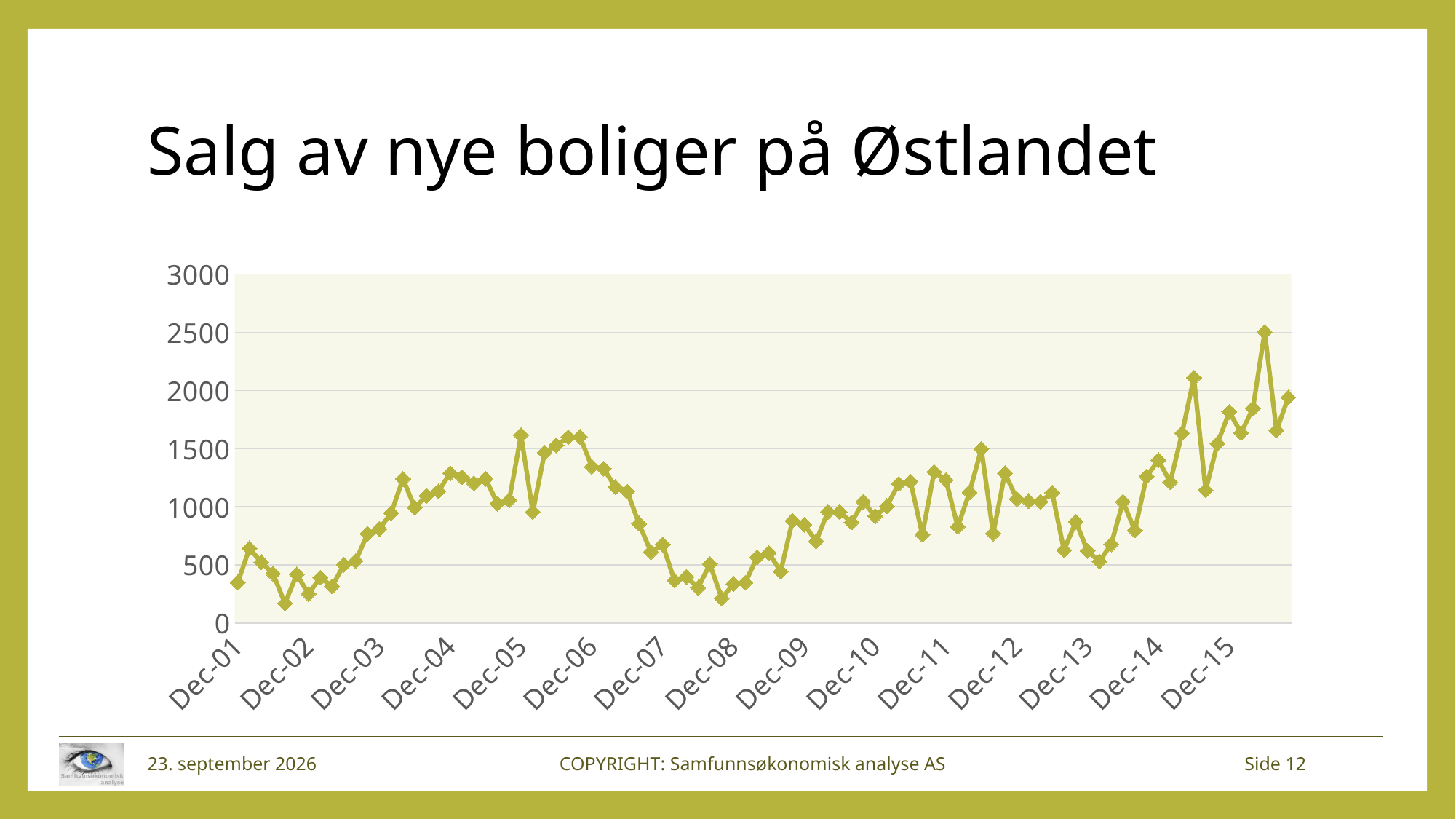
Do the values generally rise or fall between Dec-13 and the end of the series? rise Is the first plotted value (at Dec-01) greater or less than 500? less What is the highest value shown on the y axis? 3000 How many labelled dates are shown on the x axis? 15 Which is larger: the value at Dec-01 or the last value in the series? the last value in the series Is the highest plotted value in the series greater or less than 2000? greater What kind of chart is shown on the slide? line chart What is the title of the chart? Salg av nye boliger på Østlandet Is the last plotted value in the series greater or less than 1500? greater Do the values generally rise or fall between Dec-06 and Dec-08? fall